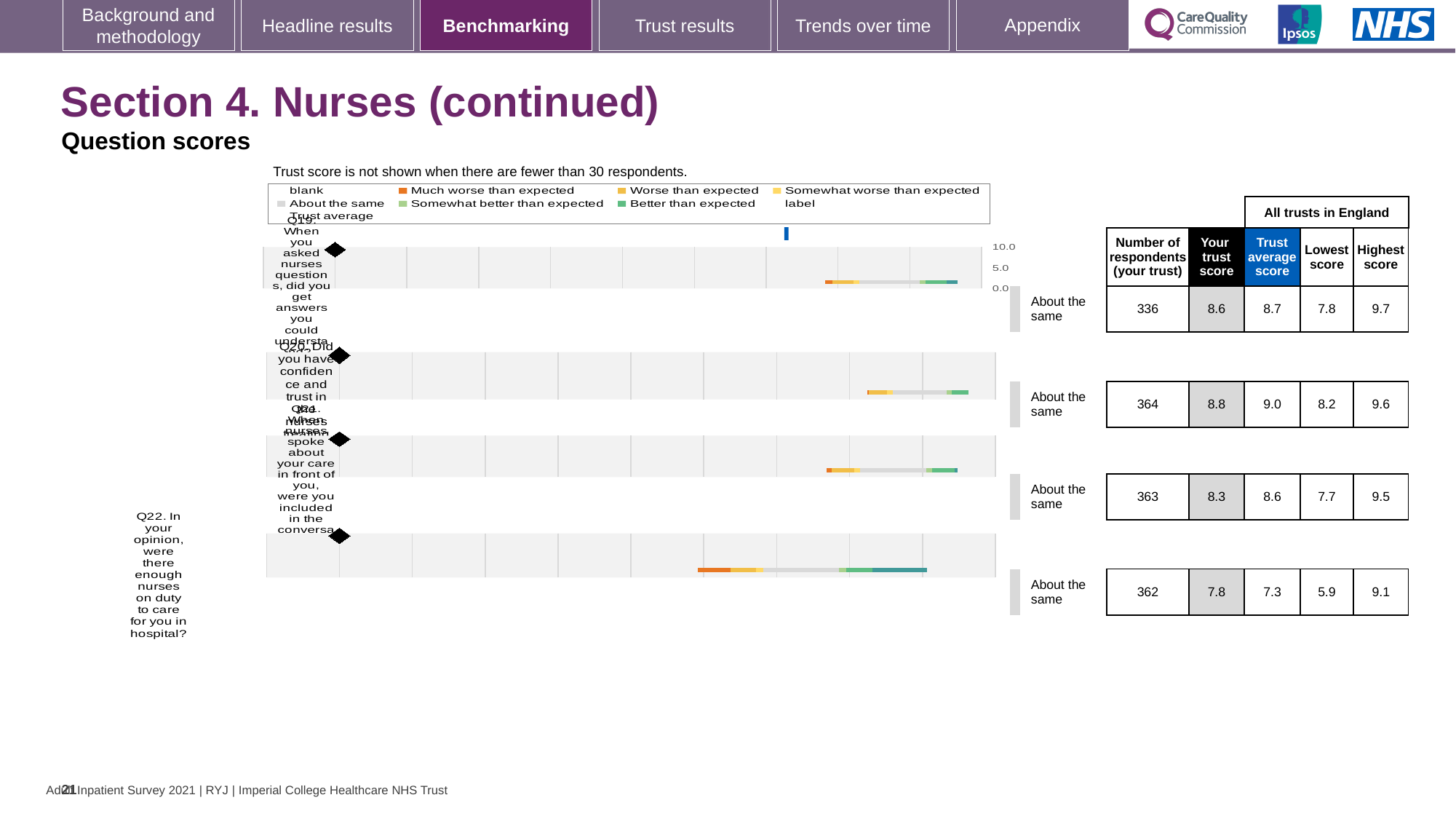
Which question has the highest 'Your trust score'? Q20 What is the difference between the trust score and the trust average score for Q22? 0.5 What is the trust average score for Q21 (When nurses spoke about your care in front of you, were you included in the conversation)? 8.6 How many questions (rows) are plotted in the chart? 4 What benchmark category is shown for Q19? About the same What kind of chart is used to show the question scores on this slide? bar chart For Q22, which is larger: the trust score or the trust average score? the trust score (7.8) What is the lowest score across all trusts in England for Q22 (were there enough nurses on duty to care for you in hospital)? 5.9 Which question has the lowest 'Your trust score'? Q22 What is the trust score for Q19 (When you asked nurses questions, did you get answers you could understand)? 8.6 What is the maximum value shown on the chart's score axis? 10.0 How many respondents answered Q20 (Did you have confidence and trust in the nurses treating you)? 364